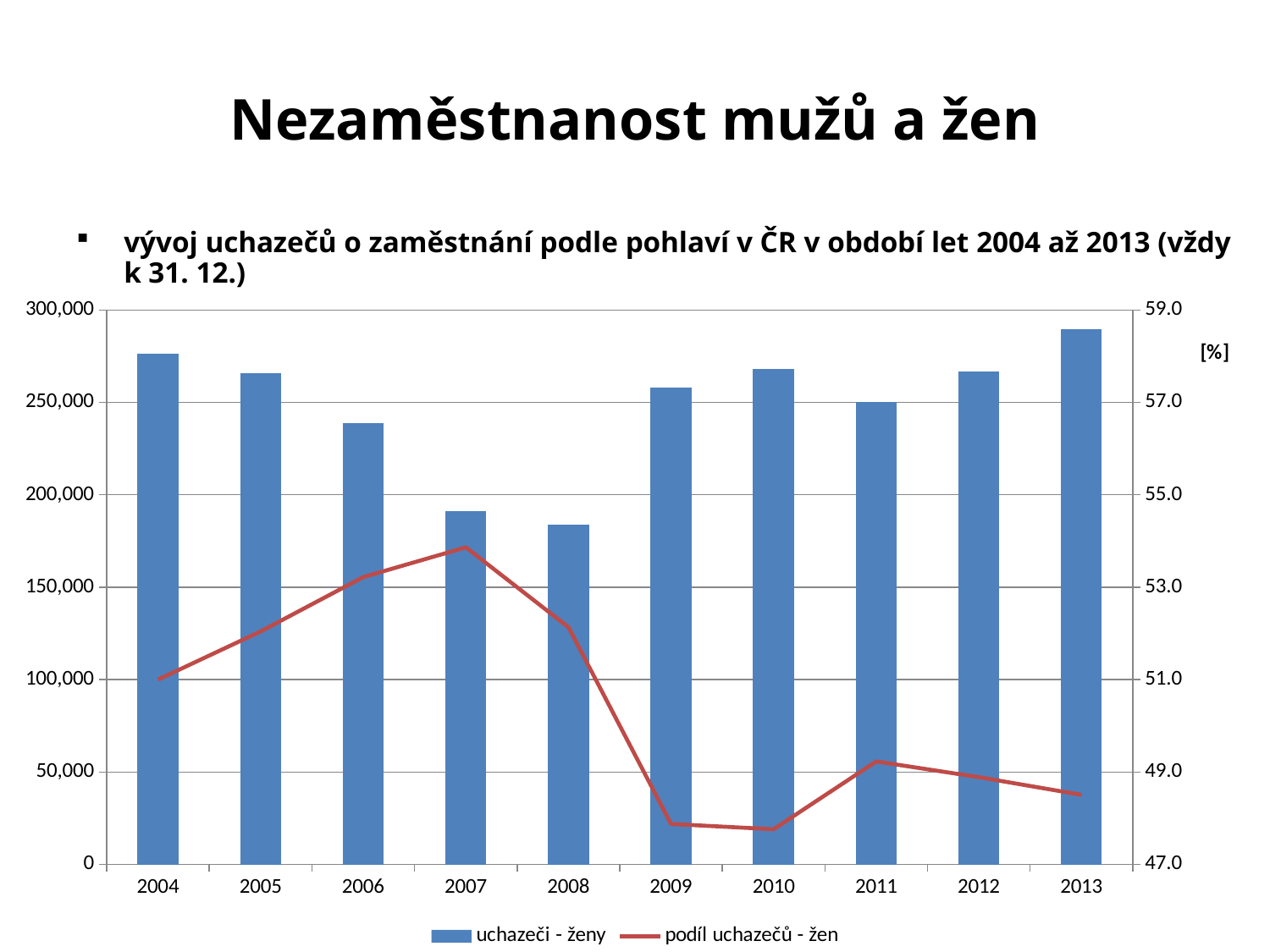
Does the line 'podíl uchazečů - žen' rise or fall from 2004 to 2007? rise Which year has the highest bar for 'uchazeči - ženy'? 2013 How many series does the legend list? 2 Is the value of 'uchazeči - ženy' for 2013 greater or less than 250,000? greater Is the value of 'uchazeči - ženy' for 2007 greater or less than 200,000? less Which year has a larger value for 'uchazeči - ženy', 2004 or 2006? 2004 Is the value of 'podíl uchazečů - žen' for 2007 greater or less than 53.0? greater How many years are shown on the x axis? 10 In which year does the line 'podíl uchazečů - žen' reach its highest point? 2007 What type of chart is shown on the slide? A combined bar and line chart Which year has the lowest bar for 'uchazeči - ženy'? 2008